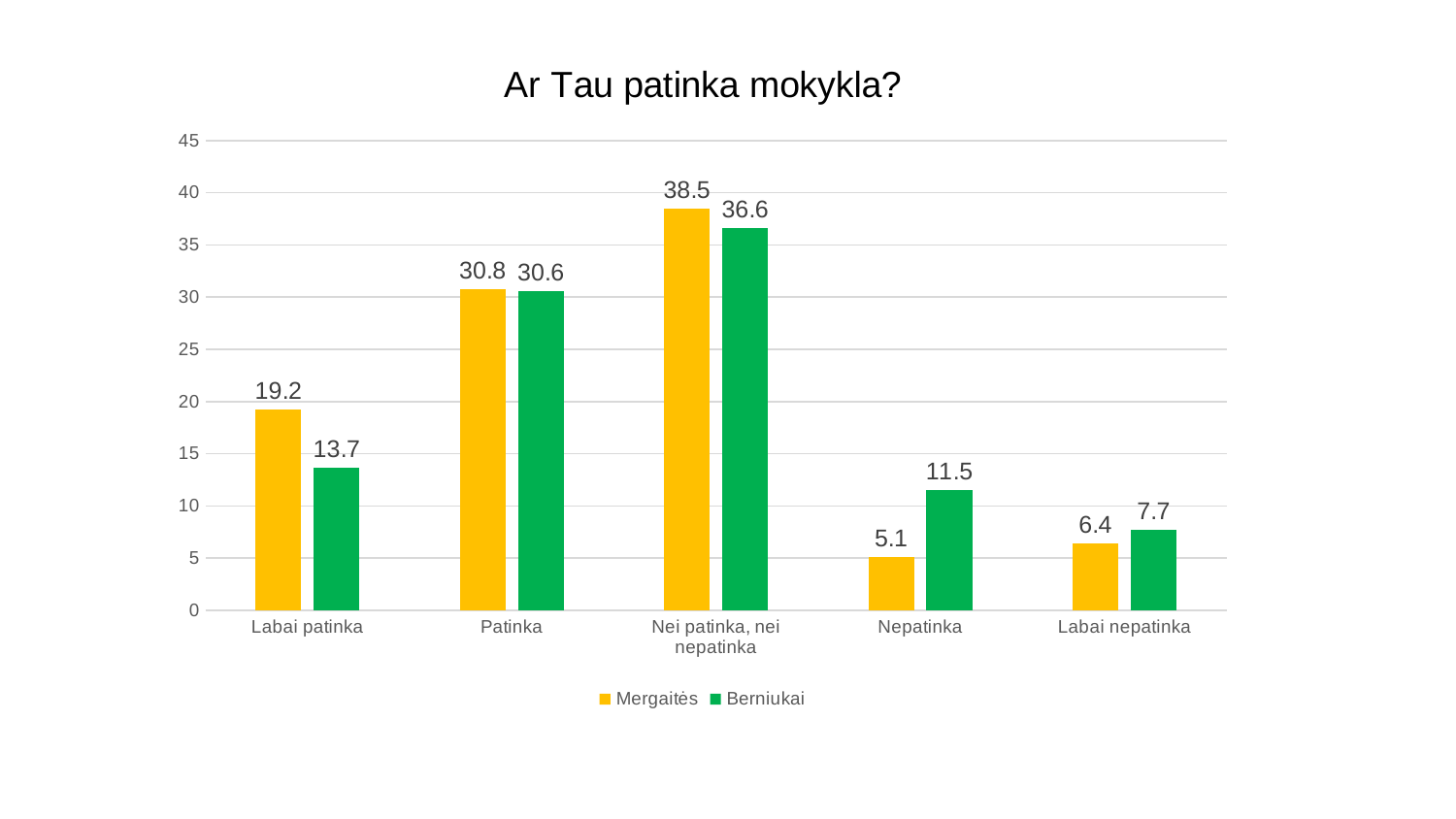
Which category has the highest value for Mergaitės? Nei patinka, nei nepatinka Which category has the lowest value for Berniukai? Labai nepatinka How many categories are shown on the x axis? 5 What is the title of the chart? Ar Tau patinka mokykla? Which is larger in the Nepatinka category, the Mergaitės value or the Berniukai value? Berniukai What kind of chart is shown on the slide? Bar chart What is the difference between the Mergaitės and Berniukai values in the Labai patinka category? 5.5 Is the value for Berniukai in the Patinka category greater or less than 25? greater What is the value for Mergaitės in the Labai patinka category? 19.2 What is the value for Berniukai in the Nei patinka, nei nepatinka category? 36.6 How many series does the legend list? 2 What is the value for Berniukai in the Nepatinka category? 11.5